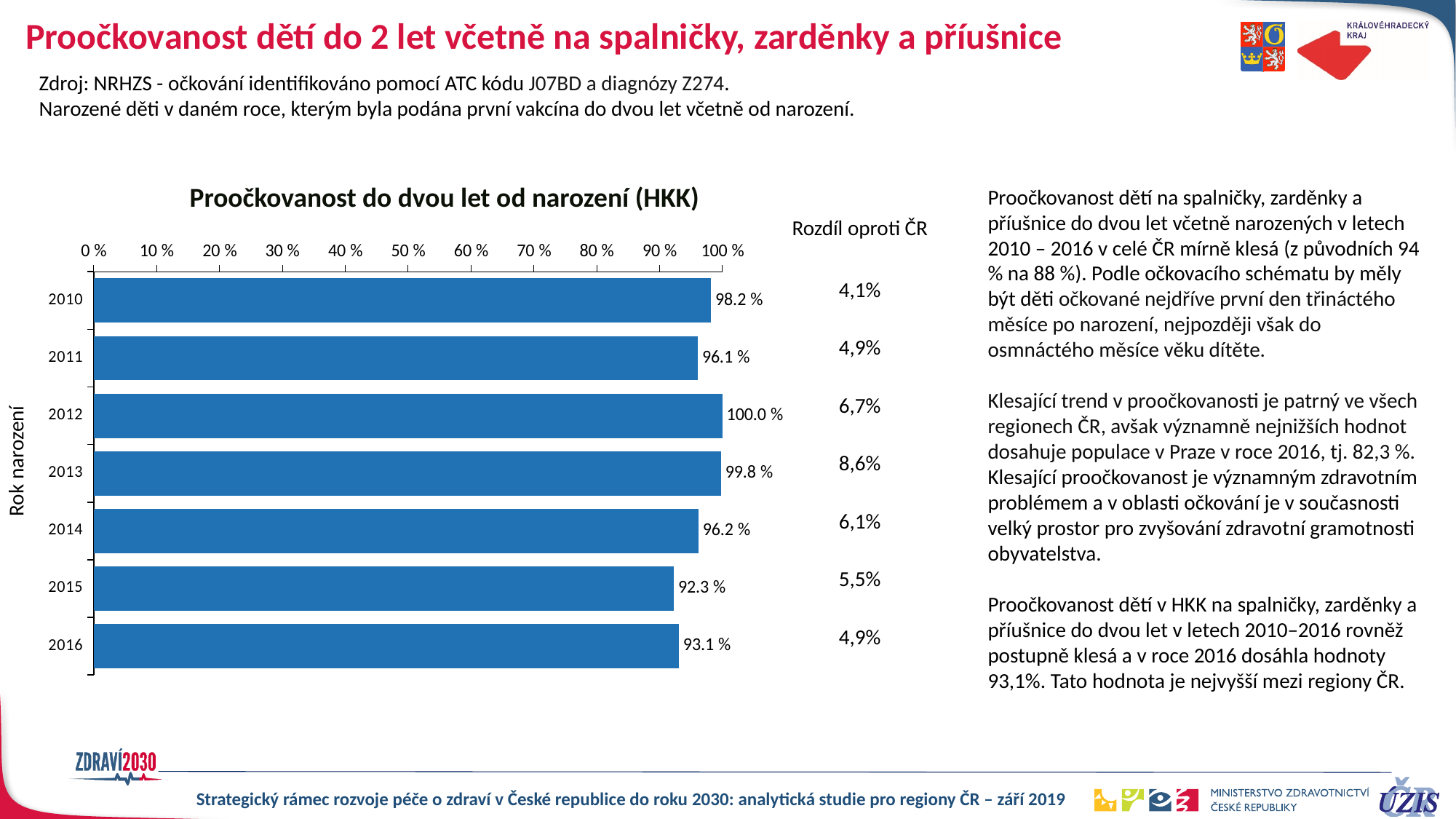
What is the value for 2010 in the chart? 98.2 % Is the value for 2015 greater or less than 90 %? greater What is the title of the chart? Proočkovanost do dvou let od narození (HKK) Which year has the highest value in the chart? 2012 How many years are shown in the chart? 7 What kind of chart is shown on the slide? bar chart Which year has the larger value, 2013 or 2015? 2013 What is the value for 2016 in the chart? 93.1 % Which year has the lowest value in the chart? 2015 What is the difference between the values for 2010 and 2016? 5.1 percentage points What is the value for 2013 in the chart? 99.8 % Do the values generally rise or fall from 2012 to 2016? fall